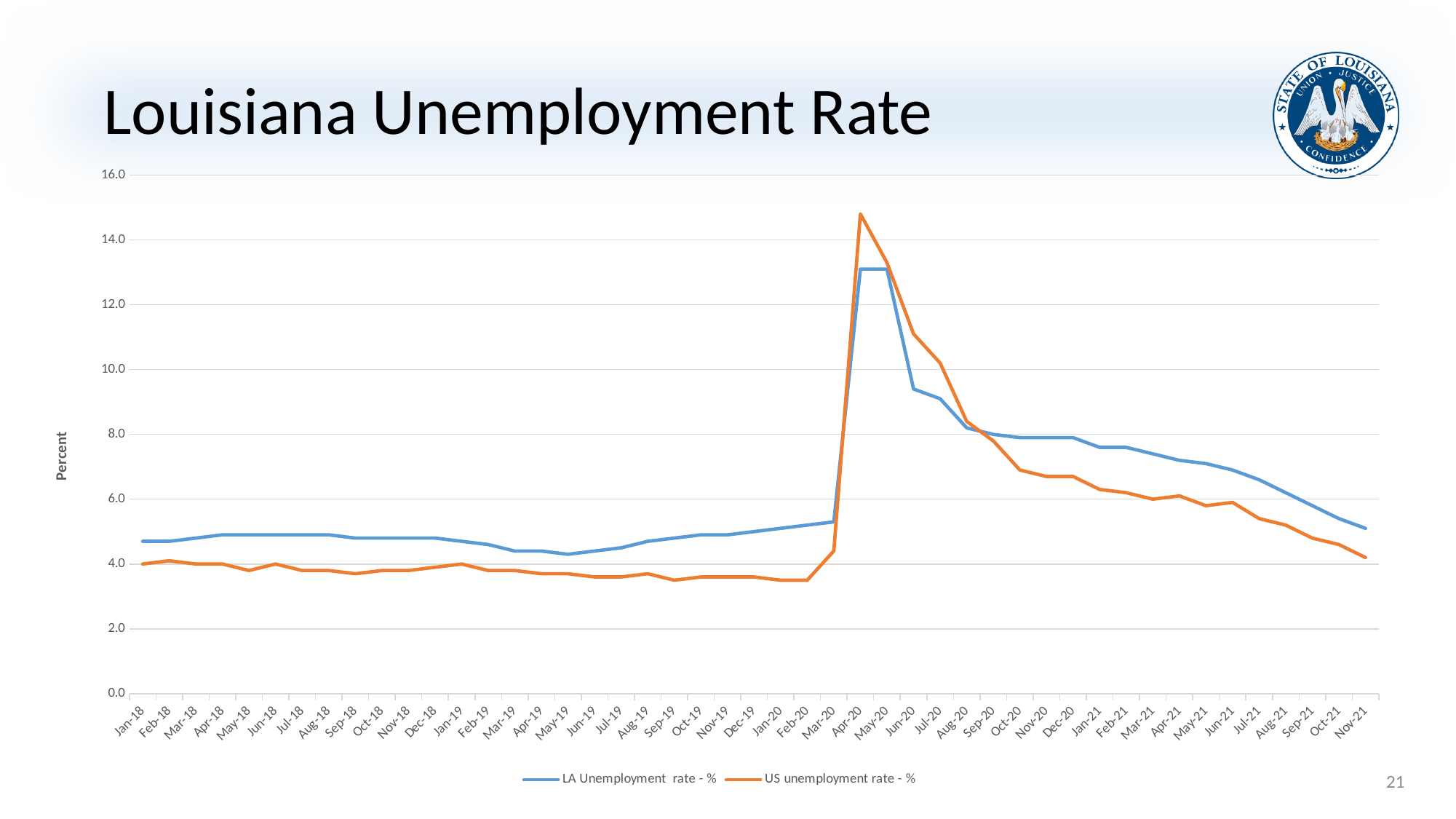
How many months are plotted along the x axis? 47 Is the LA unemployment rate in Nov-21 greater or less than 6.0? less Is the LA unemployment rate in Apr-20 greater or less than 12.0? greater Is the US unemployment rate in Feb-20 greater or less than 4.0? less In which month does the US unemployment rate reach its highest value? Apr-20 What is the label on the y axis? Percent From Apr-20 to Nov-21, does the LA unemployment rate rise or fall? fall How many series does the legend list? 2 What kind of chart is shown on the slide? line chart In Apr-20, which is higher: the LA unemployment rate or the US unemployment rate? US unemployment rate In Nov-21, which is higher: the LA unemployment rate or the US unemployment rate? LA unemployment rate